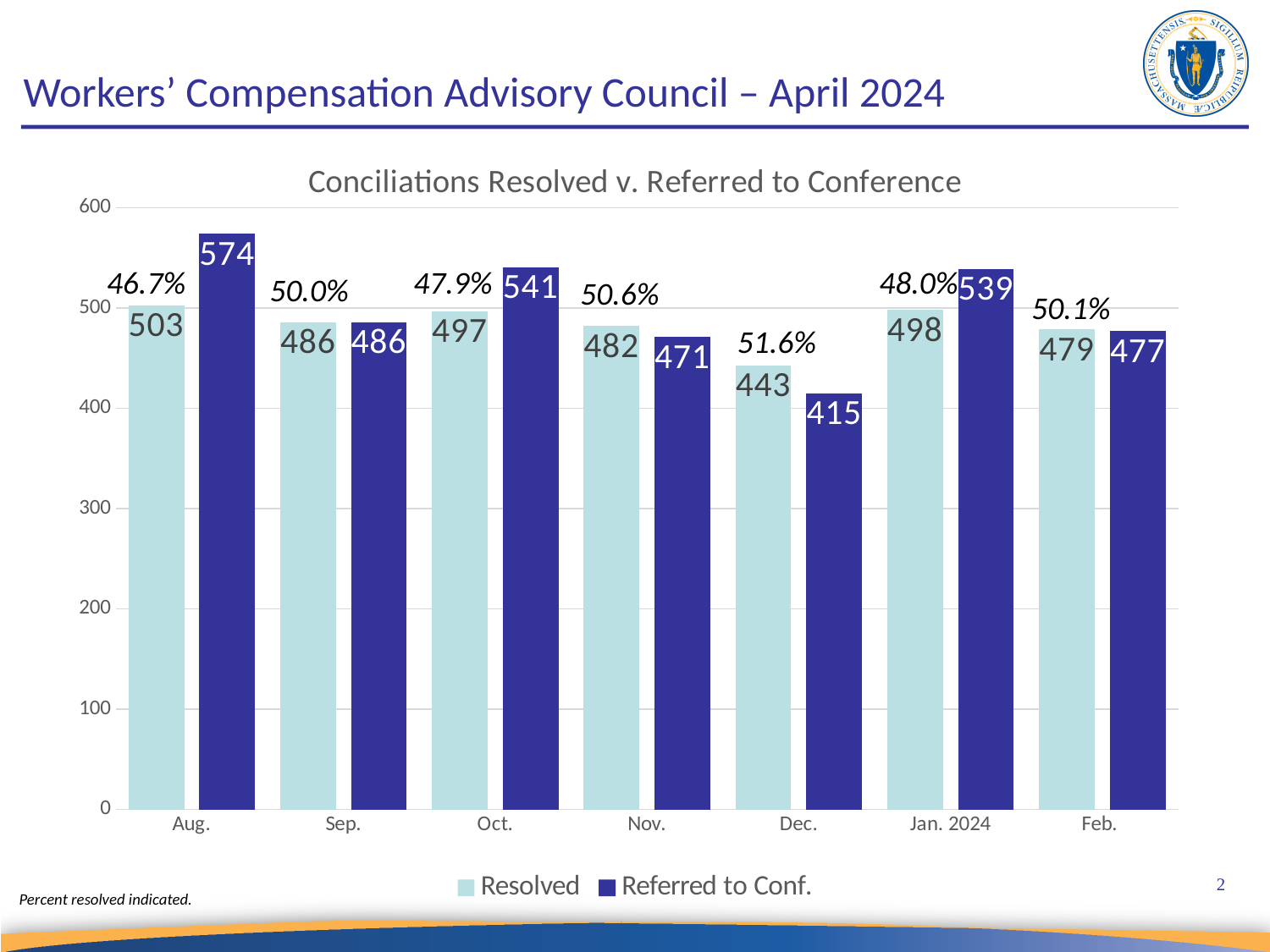
How many series does the legend list? 2 What is the Referred to Conf. value for Dec.? 415 What is the Resolved value for Aug.? 503 What is the difference between the Referred to Conf. and Resolved values for Aug.? 71 How many months are shown on the x axis? 7 Which month has the lowest Resolved value? Dec. What is the title of the chart? Conciliations Resolved v. Referred to Conference Which month has the highest Referred to Conf. value? Aug. Is the Referred to Conf. value for Jan. 2024 greater or less than 500? greater What percent resolved is indicated for Nov.? 50.6% What kind of chart is shown? bar chart Which is larger for Oct., the Resolved value or the Referred to Conf. value? Referred to Conf.